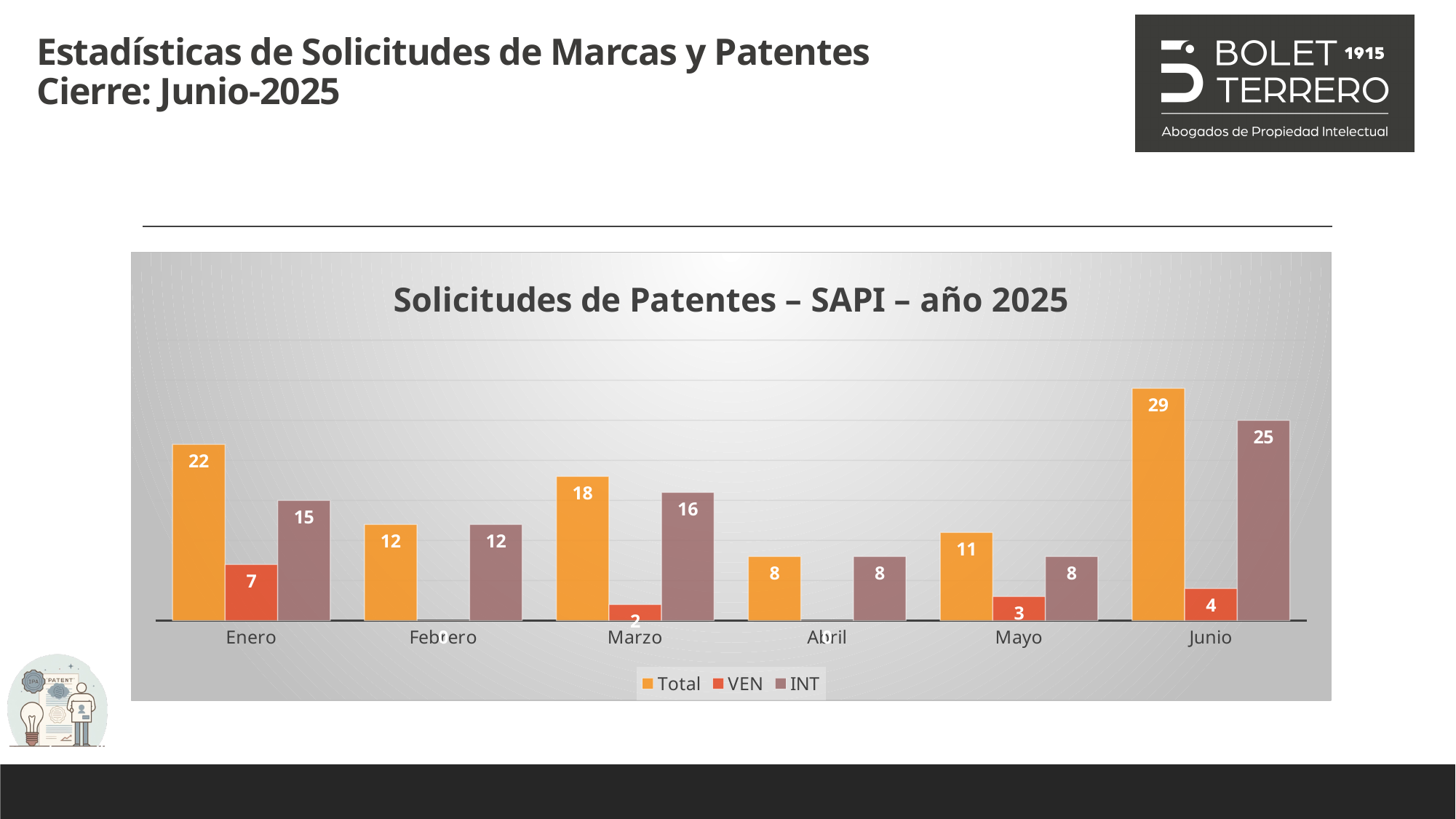
What is the difference between the Total values for Junio and Enero? 7 Which month has the highest Total value? Junio What is the VEN value for Mayo? 3 How many months are shown on the x axis? 6 Which month has the lowest Total value? Abril What is the VEN value for Enero? 7 Which is larger, the INT value for Enero or the INT value for Febrero? Enero What is the INT value for Marzo? 16 What is the Total value for Junio? 29 What is the title of the chart? Solicitudes de Patentes – SAPI – año 2025 How many series does the legend list? 3 What kind of chart is shown? Bar chart